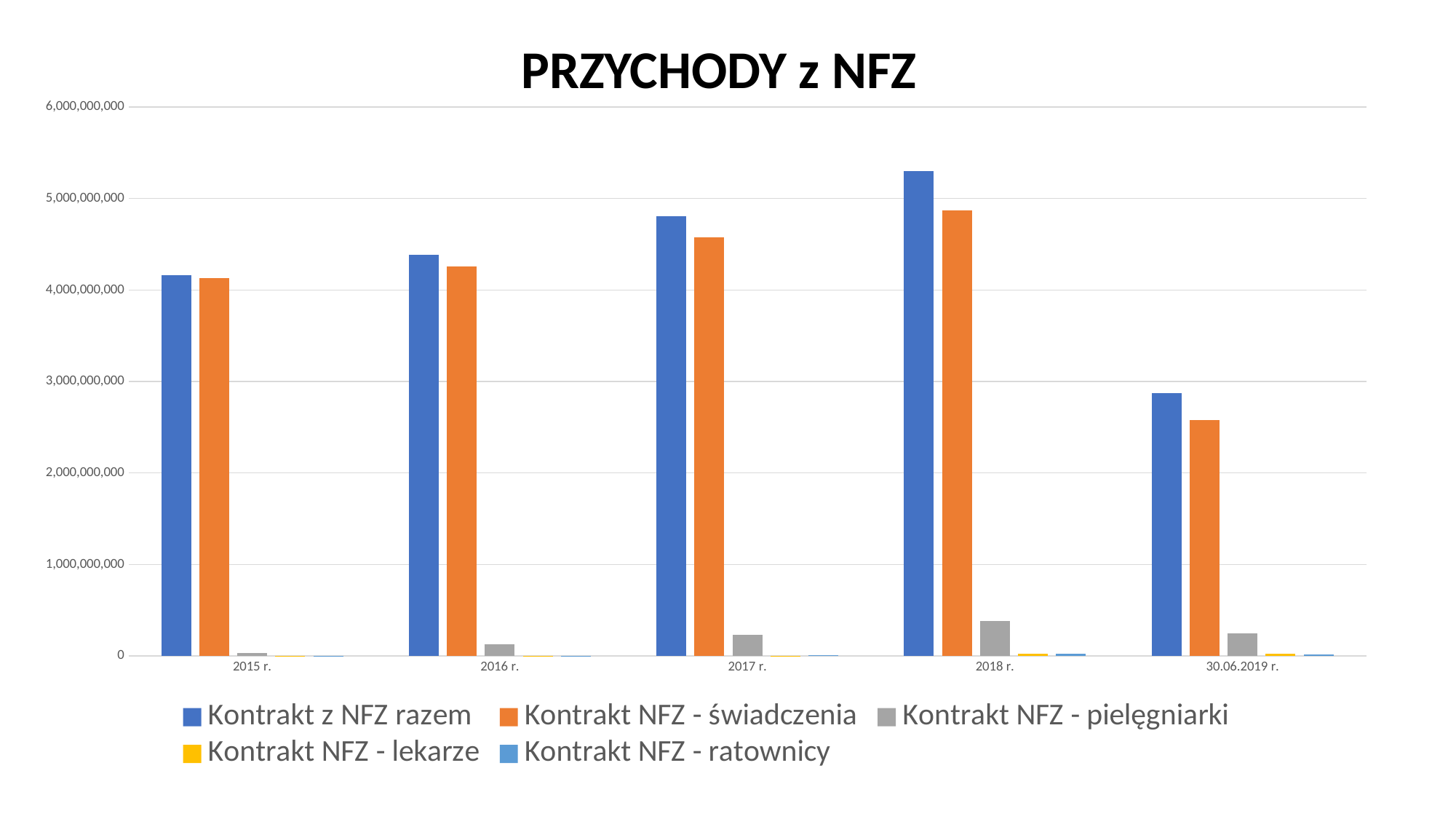
Is the value for 'Kontrakt NFZ - świadczenia' in 2017 r. greater or less than 4,000,000,000? greater Does the value for 'Kontrakt z NFZ razem' rise or fall from 2015 r. to 2018 r.? rise Is the value for 'Kontrakt z NFZ razem' in 2018 r. greater or less than 5,000,000,000? greater In which period is the value for 'Kontrakt NFZ - pielęgniarki' highest? 2018 r. How many categories (periods) are shown on the x axis? 5 What type of chart is shown on the slide? bar chart In which period is the value for 'Kontrakt z NFZ razem' lowest? 30.06.2019 r. In which period is the value for 'Kontrakt z NFZ razem' highest? 2018 r. What is the title of the chart? PRZYCHODY z NFZ Which is larger in 2016 r.: 'Kontrakt z NFZ razem' or 'Kontrakt NFZ - pielęgniarki'? Kontrakt z NFZ razem Is the value for 'Kontrakt z NFZ razem' in 30.06.2019 r. greater or less than 3,000,000,000? less How many series does the legend list? 5